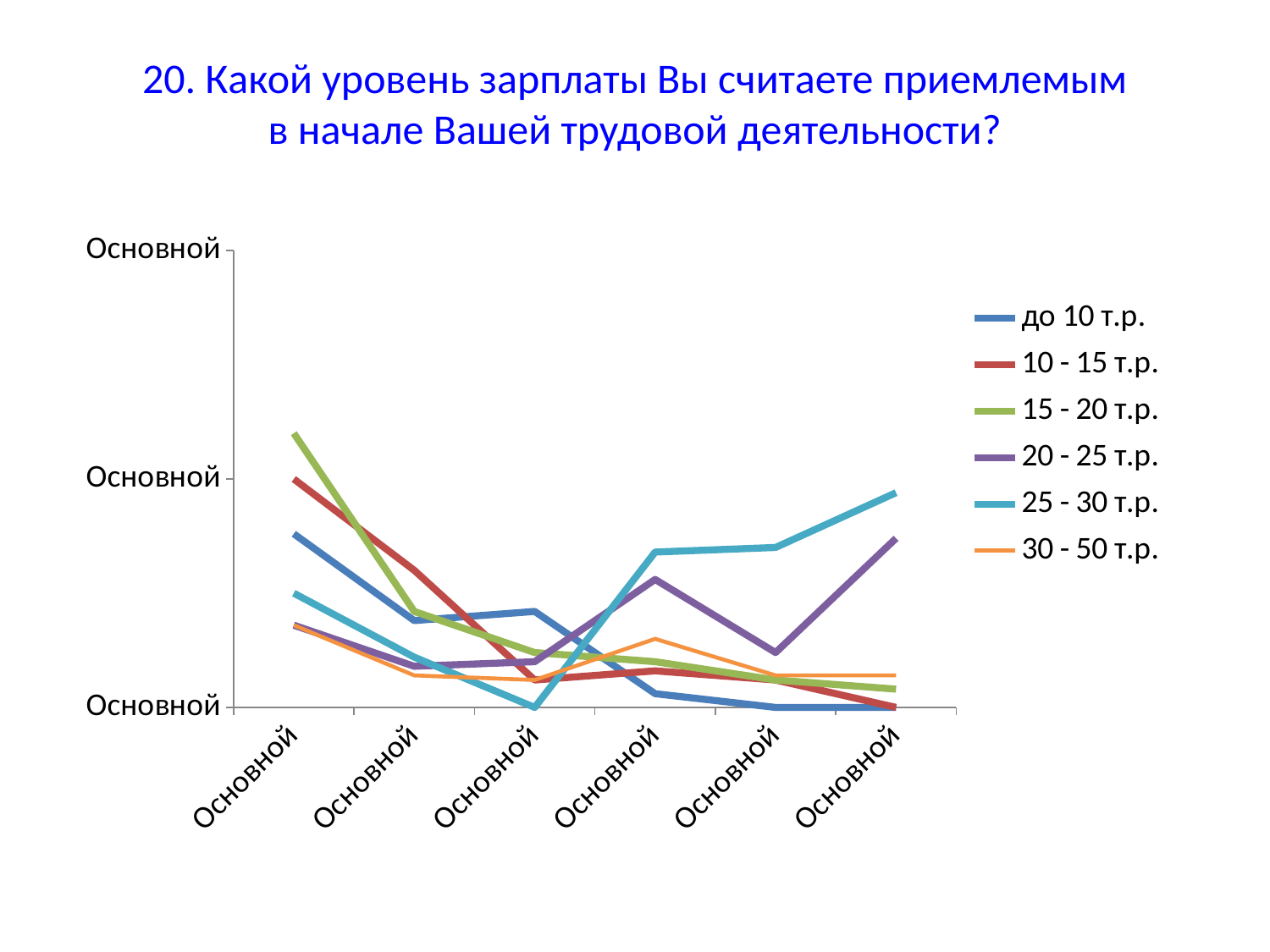
How many points along the x axis does each line have? 6 Which legend entry is shown in orange? 30 - 50 т.р. Which series is highest at the leftmost point of the x axis? 15 - 20 т.р. Does the 'до 10 т.р.' line rise or fall from the leftmost to the rightmost point? fall What is the title of the chart on the slide? 20. Какой уровень зарплаты Вы считаете приемлемым в начале Вашей трудовой деятельности? What kind of chart is shown on the slide? line chart Does the '10 - 15 т.р.' line rise or fall from the leftmost to the rightmost point? fall At the leftmost point, which is higher: '15 - 20 т.р.' or '30 - 50 т.р.'? 15 - 20 т.р. How many series does the legend list? 6 Does the '25 - 30 т.р.' line rise or fall from the leftmost to the rightmost point? rise At the rightmost point, which is higher: '20 - 25 т.р.' or '15 - 20 т.р.'? 20 - 25 т.р. Which series is highest at the rightmost point of the x axis? 25 - 30 т.р.